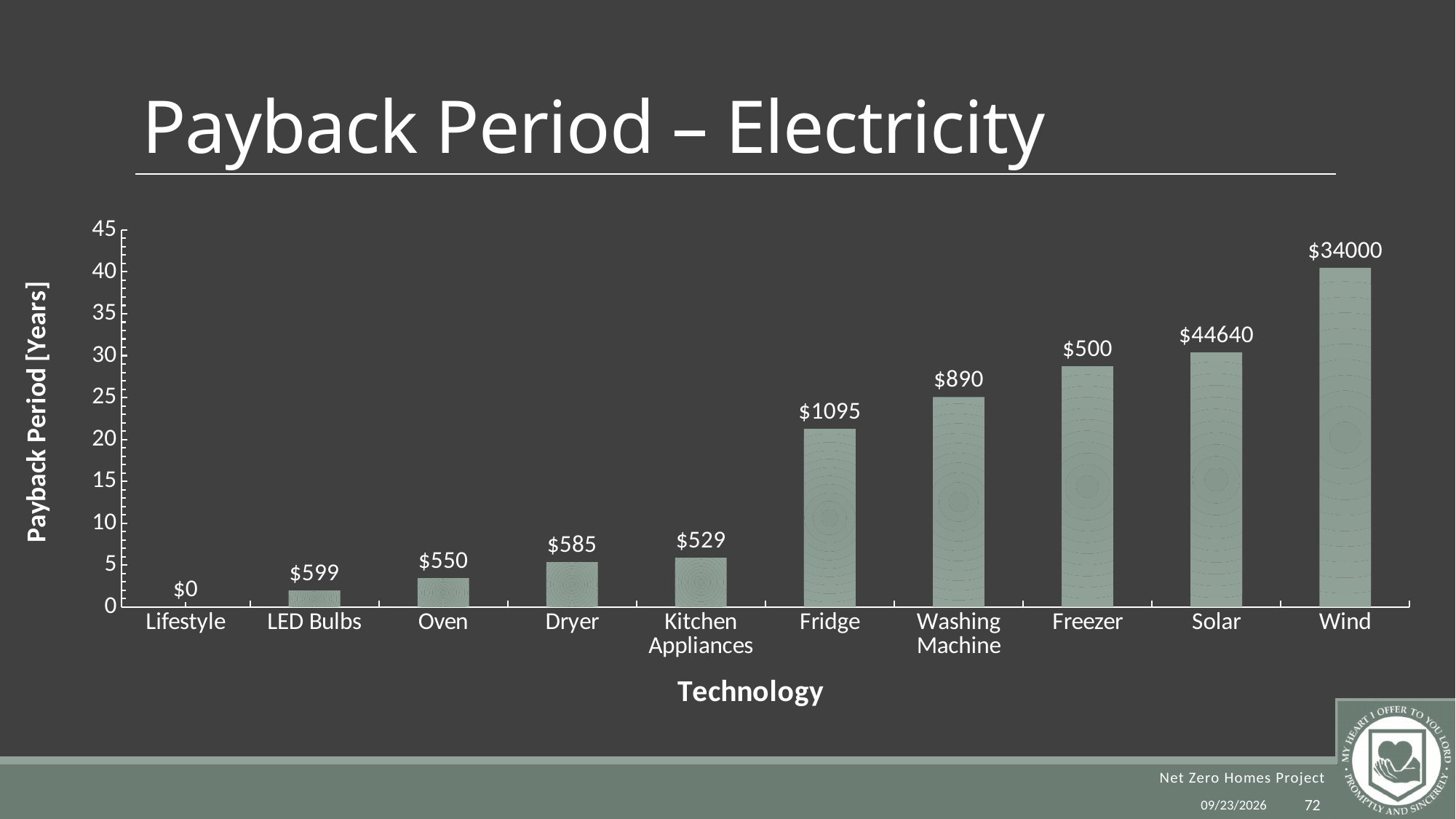
Is the payback period for Oven greater or less than 5 years? less What data label is printed above the Solar bar? $44640 Which has a longer payback period, Fridge or Dryer? Fridge What is the label on the vertical axis of the chart? Payback Period [Years] What data label is printed above the Wind bar? $34000 Is the payback period for Wind greater or less than 35 years? greater Do the payback periods generally rise or fall moving from left to right along the x axis? rise What kind of chart is shown on the slide? bar chart Which technology has the shortest payback period? Lifestyle What data label is printed above the Fridge bar? $1095 Which technology has the longest payback period? Wind How many technologies are shown on the x axis of the chart? 10